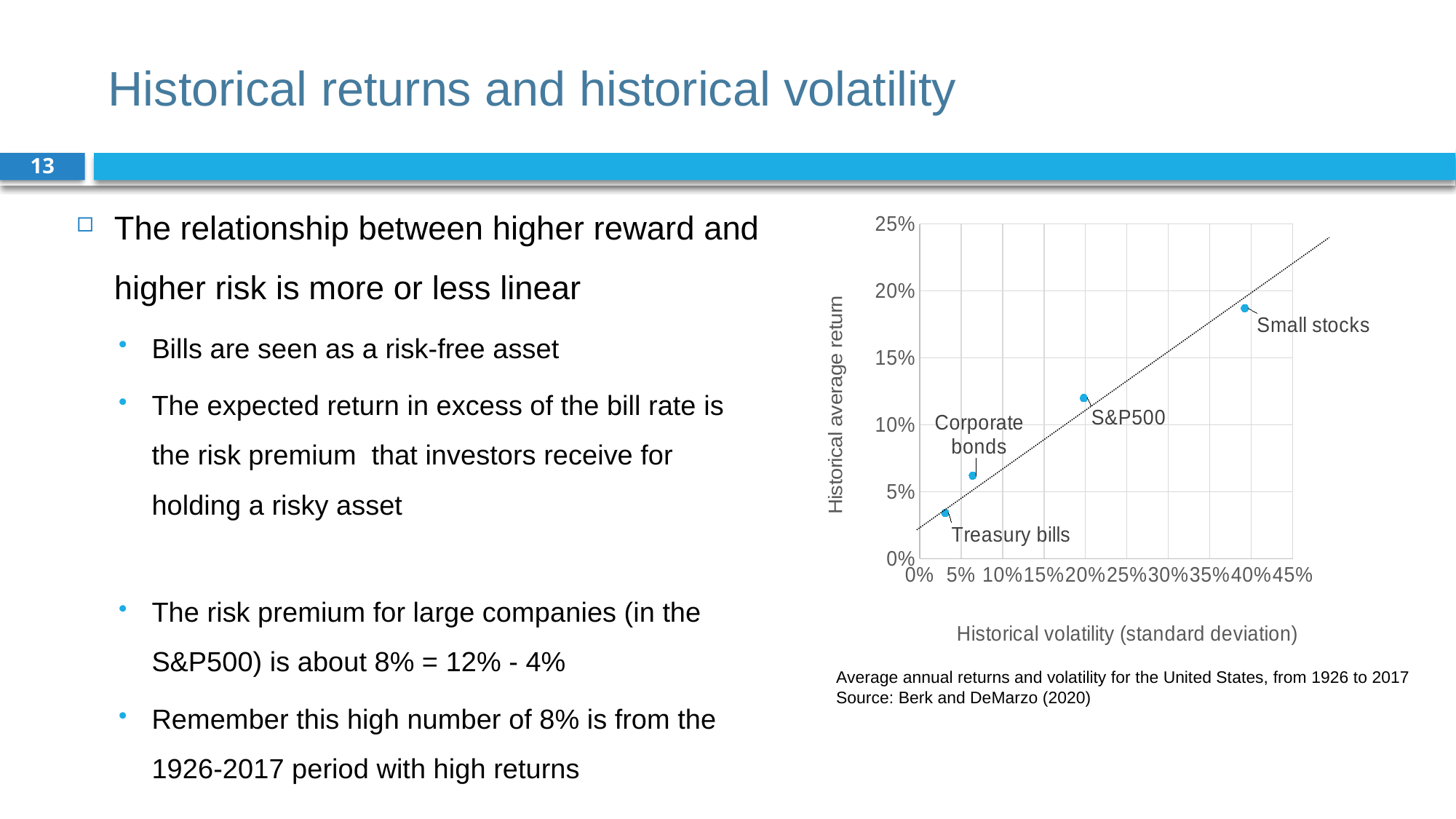
What is the label of the x axis of the chart? Historical volatility (standard deviation) Is the historical average return for Corporate bonds greater or less than 10%? less Which asset has the lowest historical volatility? Treasury bills What kind of chart is shown on the slide? scatter chart Which asset has the highest historical volatility? Small stocks How many data points are plotted in the chart? 4 Which has a higher historical average return, S&P500 or Corporate bonds? S&P500 Which asset has the lowest historical average return? Treasury bills Which asset has the highest historical average return? Small stocks Is the historical volatility for S&P500 greater or less than 15%? greater As historical volatility increases along the x axis, do the historical average returns rise or fall? rise Is the historical average return for Small stocks greater or less than 15%? greater